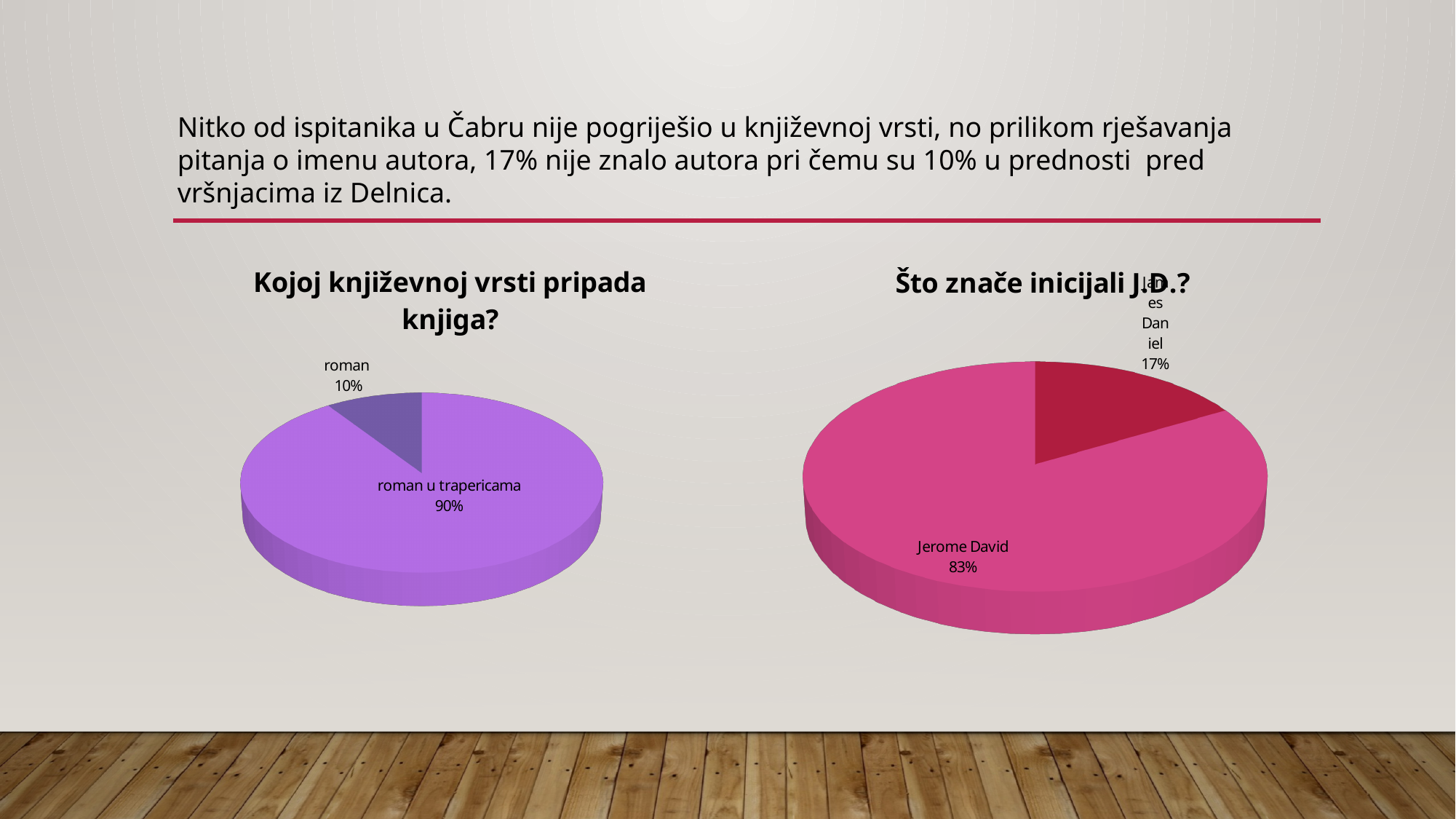
In the chart titled "Što znače inicijali J.D.?", what share does "Jerome David" have? 83% In the chart titled "Što znače inicijali J.D.?", what is the difference in percentage points between the "Jerome David" slice (83%) and the other slice (17%)? 66 In the chart titled "Kojoj književnoj vrsti pripada knjiga?", which category has the smallest slice? roman In the chart titled "Kojoj književnoj vrsti pripada knjiga?", what is the difference in percentage points between "roman u trapericama" and "roman"? 80 How many slices does the chart titled "Kojoj književnoj vrsti pripada knjiga?" have? 2 In the chart titled "Kojoj književnoj vrsti pripada knjiga?", what share does "roman" have? 10% In the chart titled "Kojoj književnoj vrsti pripada knjiga?", which category has the largest slice? roman u trapericama In the chart titled "Što znače inicijali J.D.?", which category has the largest slice? Jerome David What kind of chart is the chart titled "Kojoj književnoj vrsti pripada knjiga?"? pie chart In the chart titled "Kojoj književnoj vrsti pripada knjiga?", what share does "roman u trapericama" have? 90% How many slices does the chart titled "Što znače inicijali J.D.?" have? 2 How many charts are shown on the slide? 2